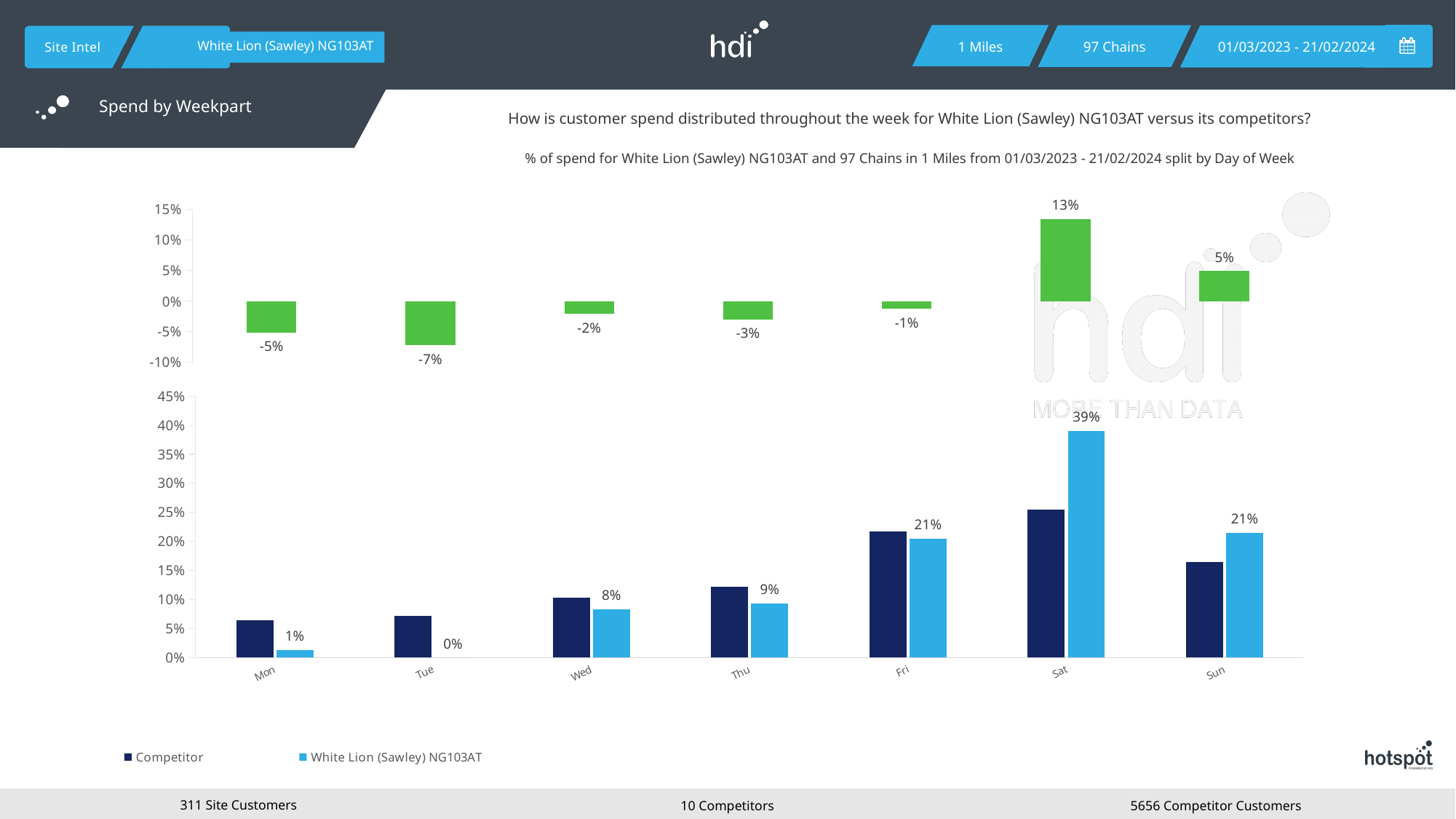
In the bottom chart, on which day is the White Lion (Sawley) NG103AT value highest? Sat In the top chart, what is the value shown for Tue? -7% In the top chart, what is the value shown for Sat? 13% In the bottom chart, on Sat, which is larger: the Competitor value or the White Lion (Sawley) NG103AT value? White Lion (Sawley) NG103AT In the bottom chart, which colour represents the Competitor series? Dark navy blue In the bottom chart, what is the difference between the White Lion (Sawley) NG103AT values for Sat and Fri? 18% In the top chart, which day has the lowest value? Tue In the bottom chart, what is the value for White Lion (Sawley) NG103AT on Sat? 39% How many days of the week are shown on the x axis of the bottom chart? 7 What kind of chart is the bottom chart? Bar chart How many series does the legend of the bottom chart list? 2 In the bottom chart, is the Competitor value for Sat greater or less than 20%? greater